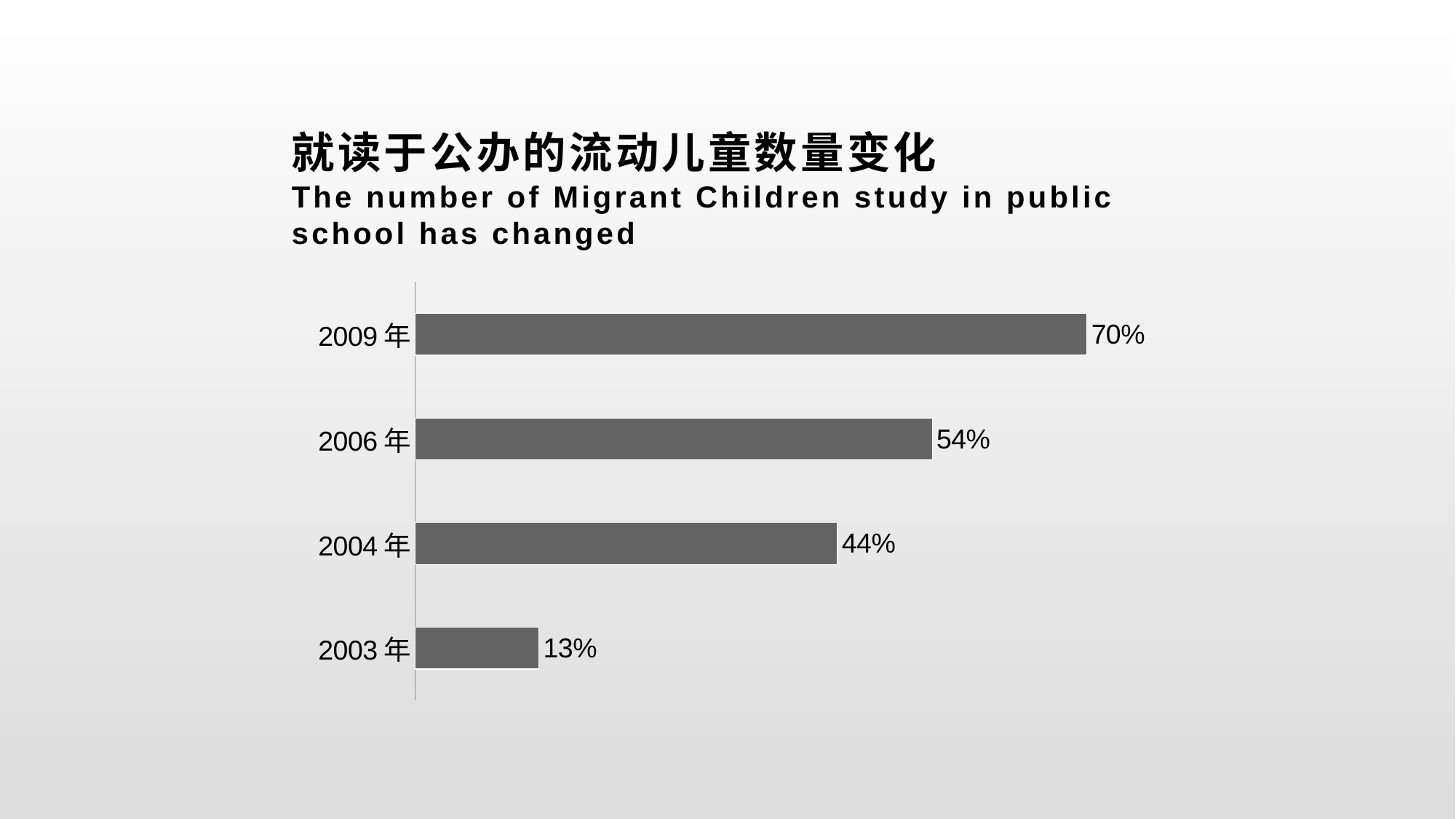
Which year has the highest value? 2009年 What is the value for 2006年? 54% What is the English title of the chart? The number of Migrant Children study in public school has changed What is the value for 2009年? 70% Which is larger, the value for 2006年 or the value for 2004年? 2006年 What is the value for 2003年? 13% What kind of chart is shown on the slide? Bar chart What is the difference between the values for 2009年 and 2003年? 57% How many years are shown in the chart? 4 What is the difference between the values for 2006年 and 2004年? 10% What is the value for 2004年? 44% Which year has the lowest value? 2003年